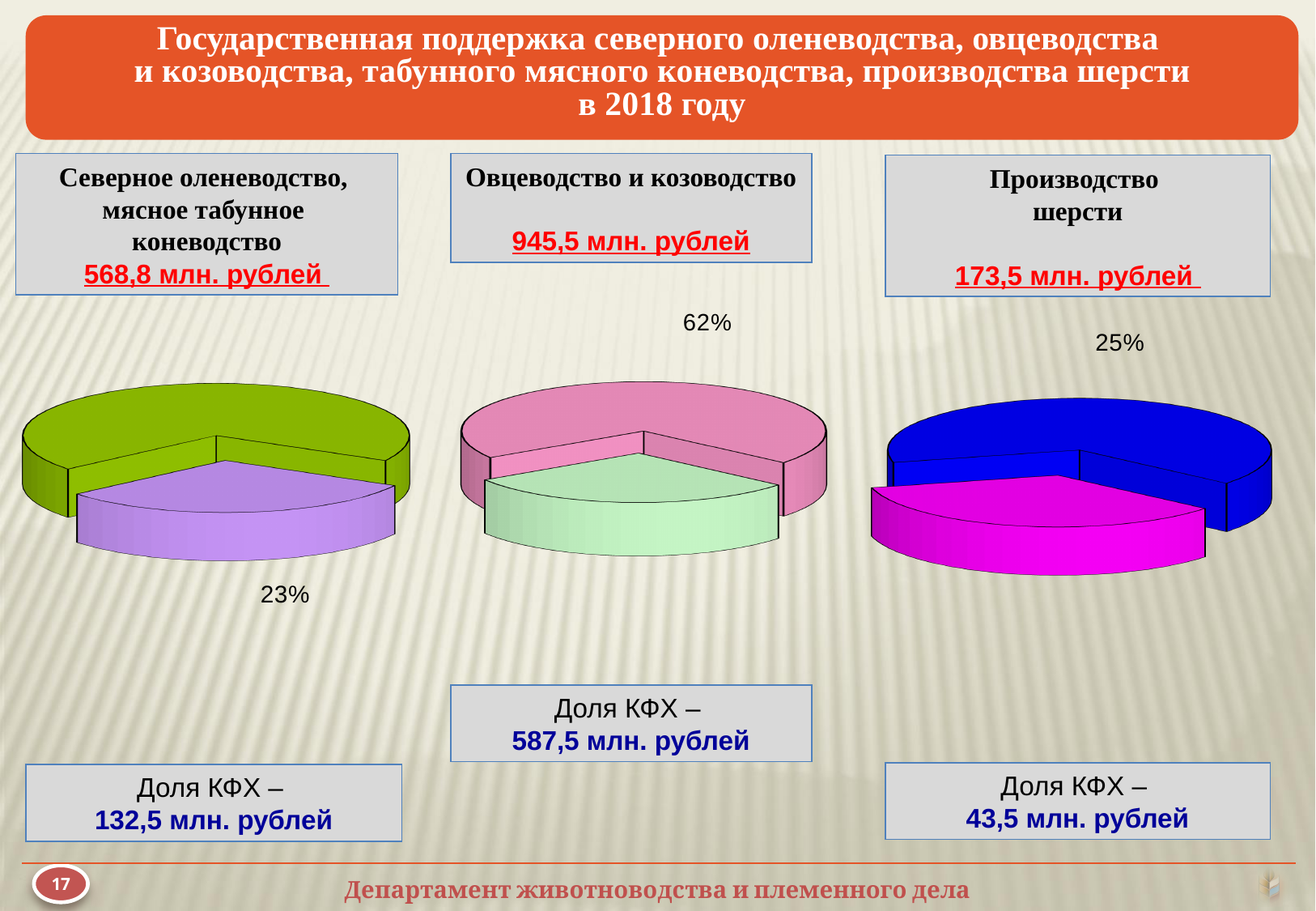
What is the difference between the labelled share in the middle pie chart and the labelled share in the left pie chart? 39% How many slices does each pie chart have? 2 Which is larger: the labelled share in the middle pie chart or the labelled share in the right pie chart? the middle pie chart (62%) How many pie charts are on the slide? 3 What total amount is shown in the box above the middle pie chart (Овцеводство и козоводство)? 945,5 млн. рублей In the left pie chart (Северное оленеводство, мясное табунное коневодство), what percentage is printed for the exploded slice? 23% What colour is the exploded slice in the right pie chart (Производство шерсти)? magenta What kind of charts are shown on the slide? pie charts Which pie chart shows the largest labelled share? Овцеводство и козоводство (62%) Which pie chart shows the smallest labelled share? Северное оленеводство, мясное табунное коневодство (23%)